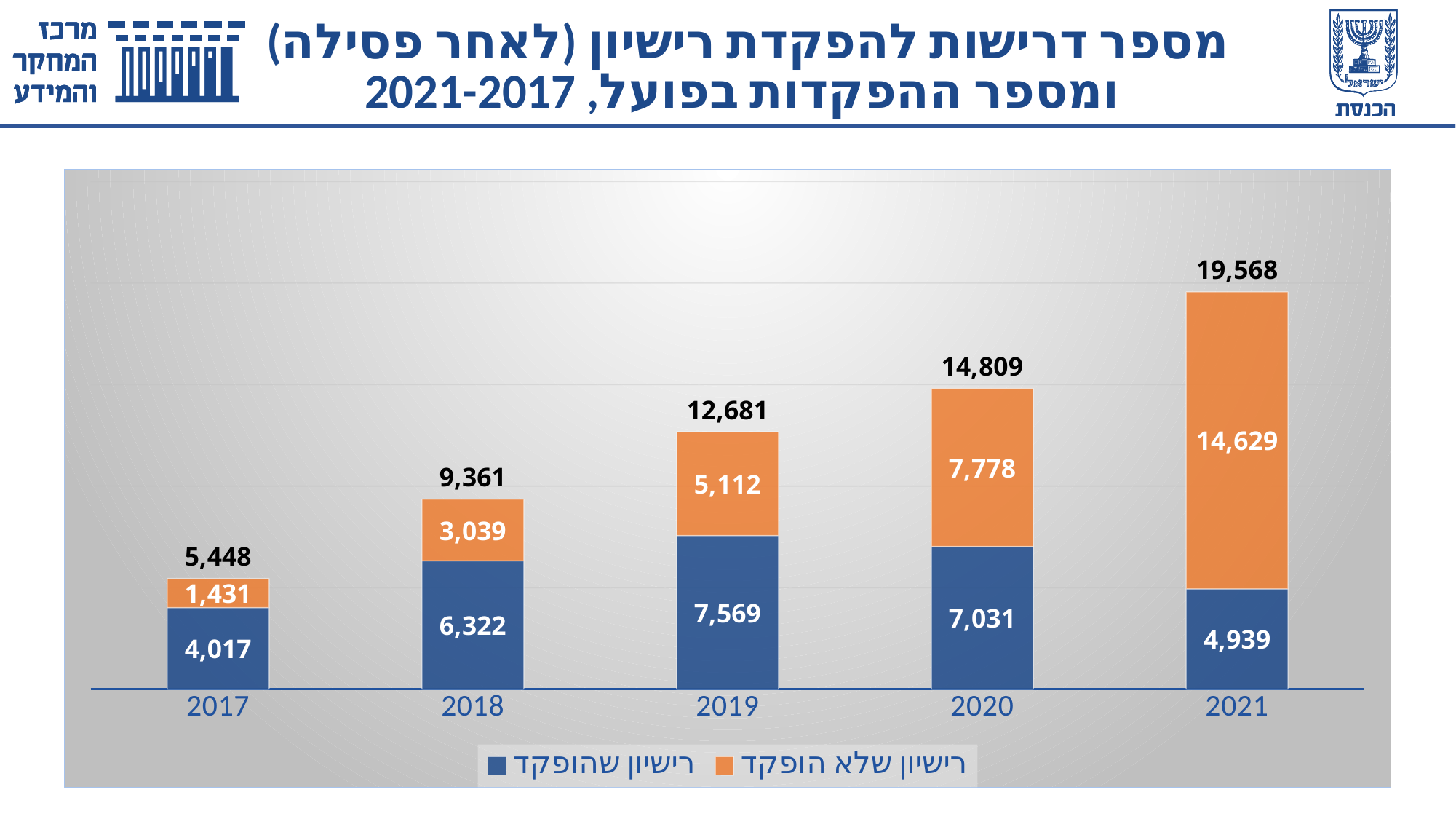
Which year has the highest total bar? 2021 What is the value of the 'רישיון שהופקד' (blue) segment for 2019? 7,569 What type of chart is shown on the slide? stacked bar chart Which year has the lowest total bar? 2017 What is the total shown above the bar for 2020? 14,809 What is the difference between the total for 2021 and the total for 2020? 4,759 How many years are shown on the x axis of the chart? 5 What is the value of the 'רישיון שלא הופקד' (orange) segment for 2021? 14,629 Do the total bar values rise or fall from 2017 to 2021? rise Which colour represents 'רישיון שלא הופקד' in the legend? orange How many series does the legend list? 2 In 2020, which segment is larger: 'רישיון שהופקד' (blue) or 'רישיון שלא הופקד' (orange)? רישיון שלא הופקד (orange)